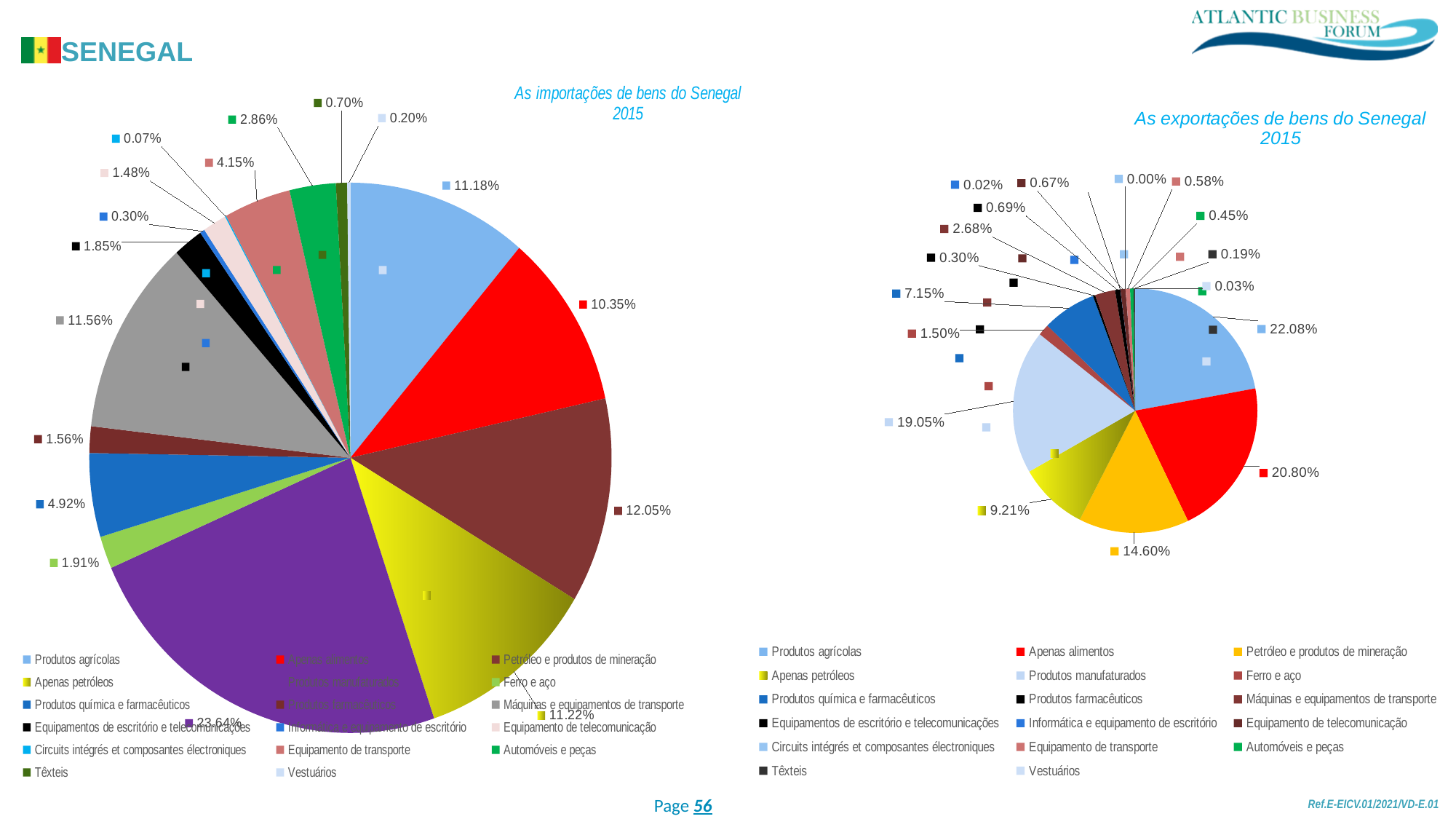
In the chart 'As exportações de bens do Senegal 2015', which category has the largest slice? Produtos agrícolas In the chart 'As importações de bens do Senegal 2015', what is the value for Apenas alimentos? 10.35% In the chart 'As importações de bens do Senegal 2015', what is the difference between Petróleo e produtos de mineração (12.05%) and Produtos agrícolas (11.18%)? 0.87% In the chart 'As exportações de bens do Senegal 2015', what is the difference between Apenas alimentos (20.80%) and Produtos manufaturados (19.05%)? 1.75% In the chart 'As exportações de bens do Senegal 2015', which is larger: Apenas petróleos or Produtos química e farmacêuticos? Apenas petróleos In the chart 'As importações de bens do Senegal 2015', what share does Produtos manufaturados have? 23.64% In the chart 'As exportações de bens do Senegal 2015', what share does Produtos agrícolas have? 22.08% In the chart 'As importações de bens do Senegal 2015', which category has the largest slice? Produtos manufaturados What type of chart is 'As exportações de bens do Senegal 2015'? Pie chart How many categories does the legend of the chart 'As importações de bens do Senegal 2015' list? 17 In the chart 'As exportações de bens do Senegal 2015', what is the value for Petróleo e produtos de mineração? 14.60% In the chart 'As importações de bens do Senegal 2015', which is larger: Produtos química e farmacêuticos or Ferro e aço? Produtos química e farmacêuticos